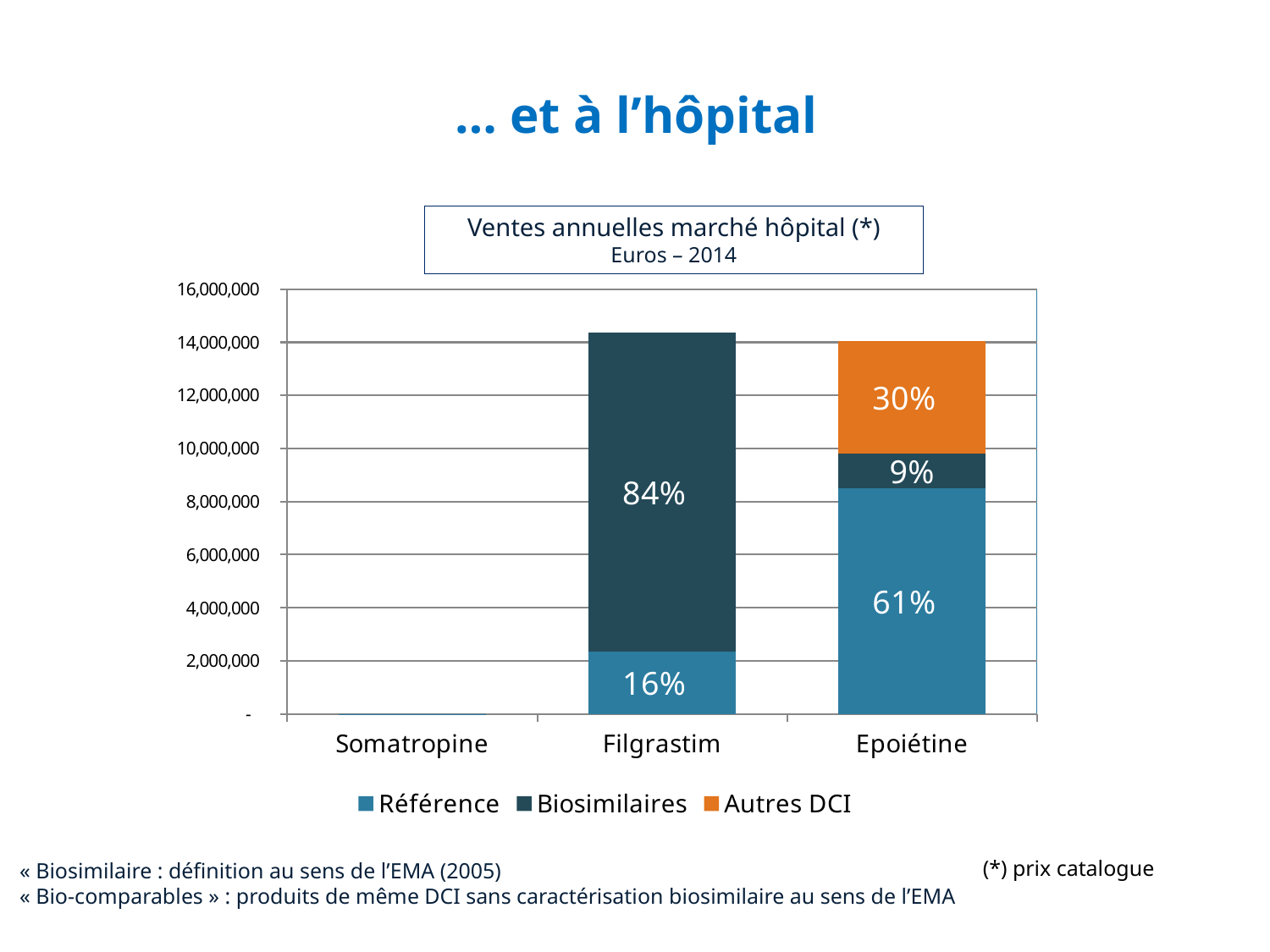
What is the title of the chart? Ventes annuelles marché hôpital (*) Euros – 2014 What percentage label is shown for the Biosimilaires segment of the Epoiétine bar? 9% What percentage label is shown for the Autres DCI segment of the Epoiétine bar? 30% What kind of chart is shown on the slide? Stacked bar chart What percentage label is shown for the Biosimilaires segment of the Filgrastim bar? 84% Is the total value of the Filgrastim bar greater or less than 12,000,000? greater How many categories are shown on the x axis of the chart? 3 What percentage label is shown for the Référence segment of the Epoiétine bar? 61% Which category has the lowest total annual sales in the chart? Somatropine What percentage label is shown for the Référence segment of the Filgrastim bar? 16% Within the Filgrastim bar, which segment is larger: Référence or Biosimilaires? Biosimilaires How many series does the chart legend list? 3